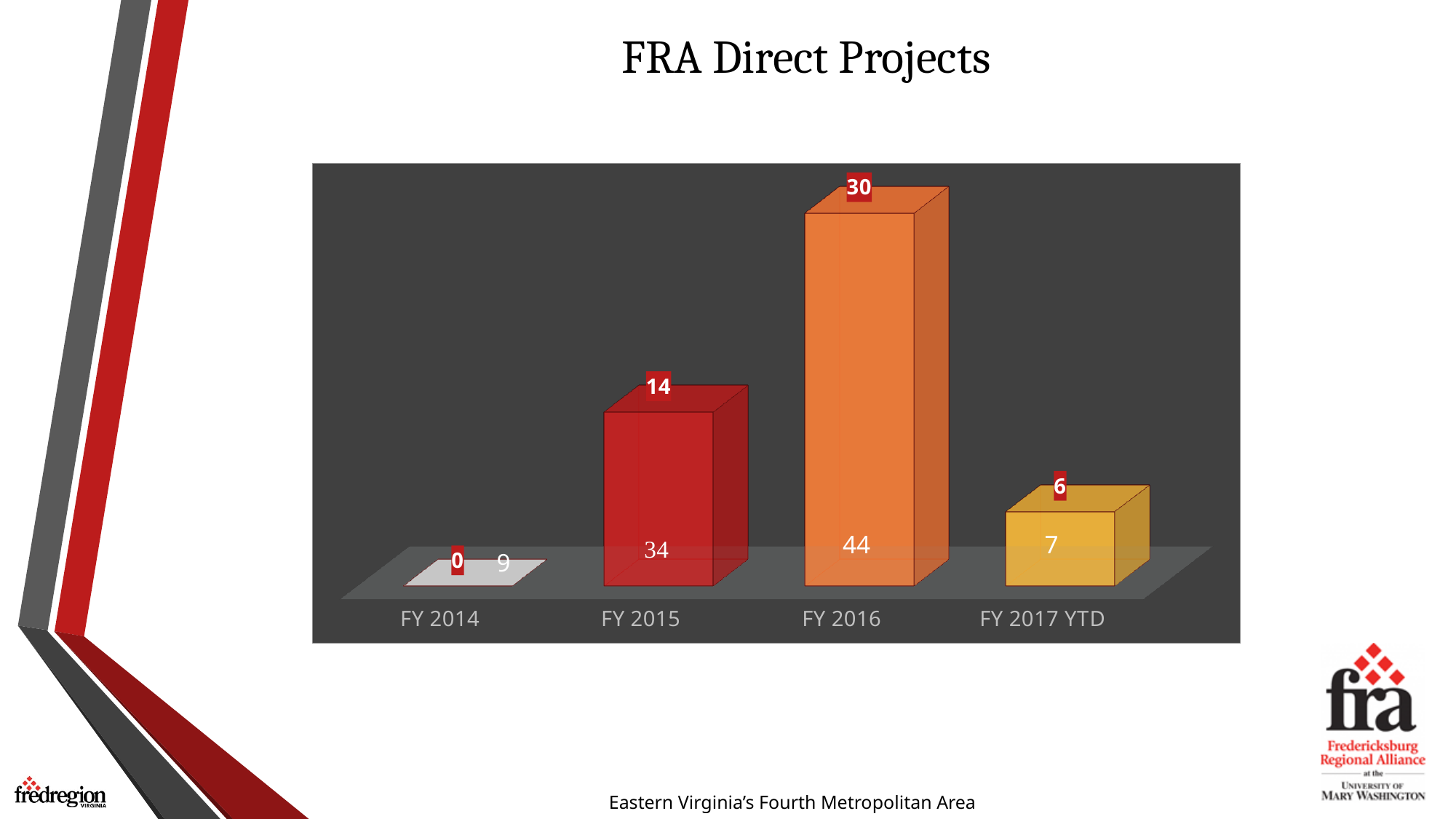
What is the difference between the values shown above the FY 2016 and FY 2015 bars? 16 Which bar is taller, FY 2015 or FY 2017 YTD? FY 2015 What value is shown above the bar for FY 2014? 0 Which fiscal year has the lowest bar? FY 2014 How many fiscal year categories are shown on the x axis? 4 Which fiscal year has the tallest bar? FY 2016 What number is printed inside the FY 2015 bar? 34 What value is shown above the bar for FY 2015? 14 What value is shown above the bar for FY 2017 YTD? 6 What number is printed inside the FY 2016 bar? 44 What value is shown above the bar for FY 2016? 30 What is the title of the chart? FRA Direct Projects